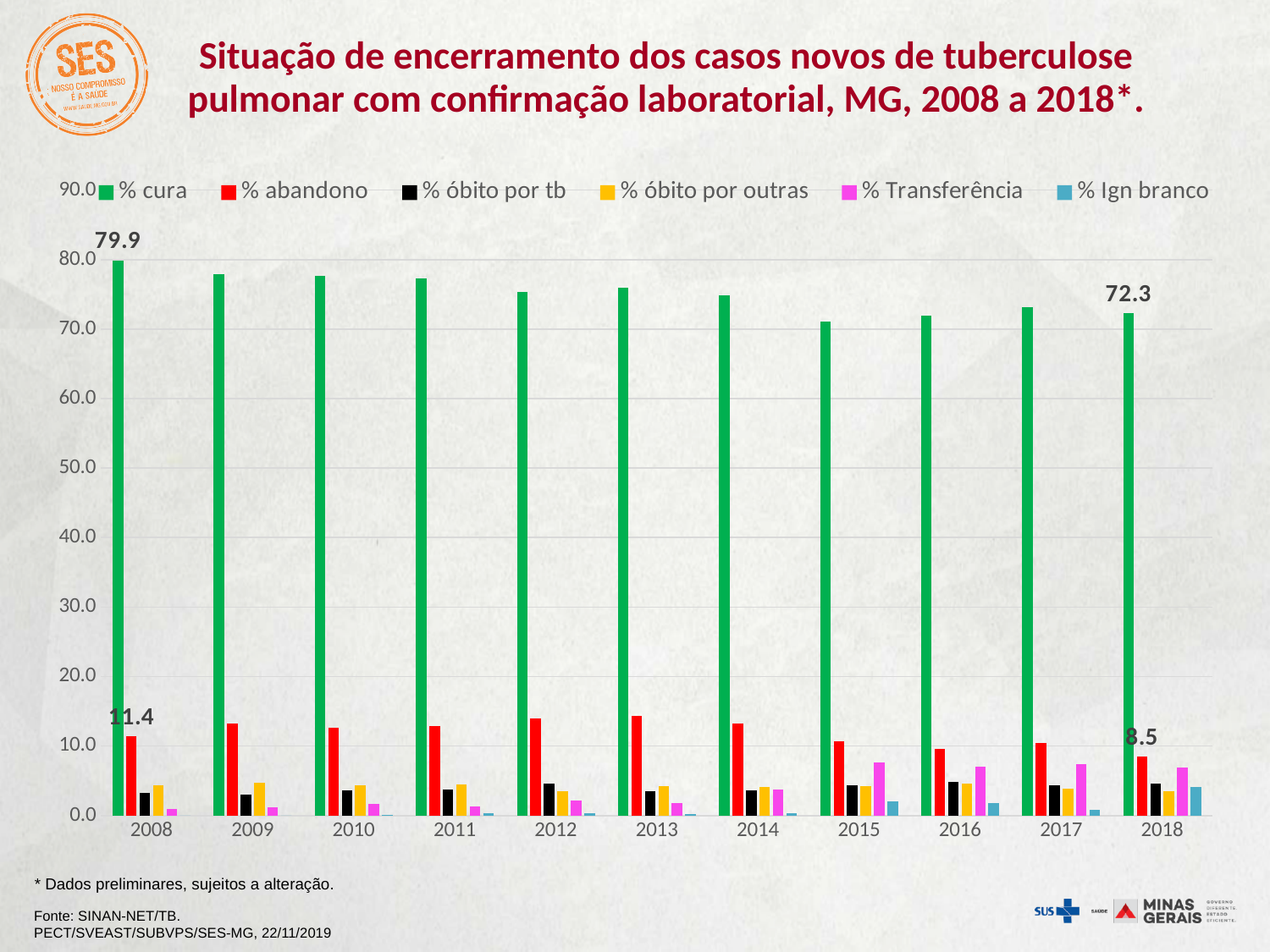
What is the value of % cura for 2008? 79.9 Is the value of % abandono for 2013 greater or less than 10.0? greater What is the difference between % abandono in 2008 and in 2018? 2.9 What is the value of % cura for 2018? 72.3 What is the value of % abandono for 2008? 11.4 What is the value of % abandono for 2018? 8.5 Which year has the larger % abandono, 2013 or 2015? 2013 By how much did % cura decrease from 2008 to 2018? 7.6 What kind of chart is shown on the slide? Bar chart How many series does the legend list? 6 How many years are shown on the x axis? 11 Which year has the highest % cura? 2008